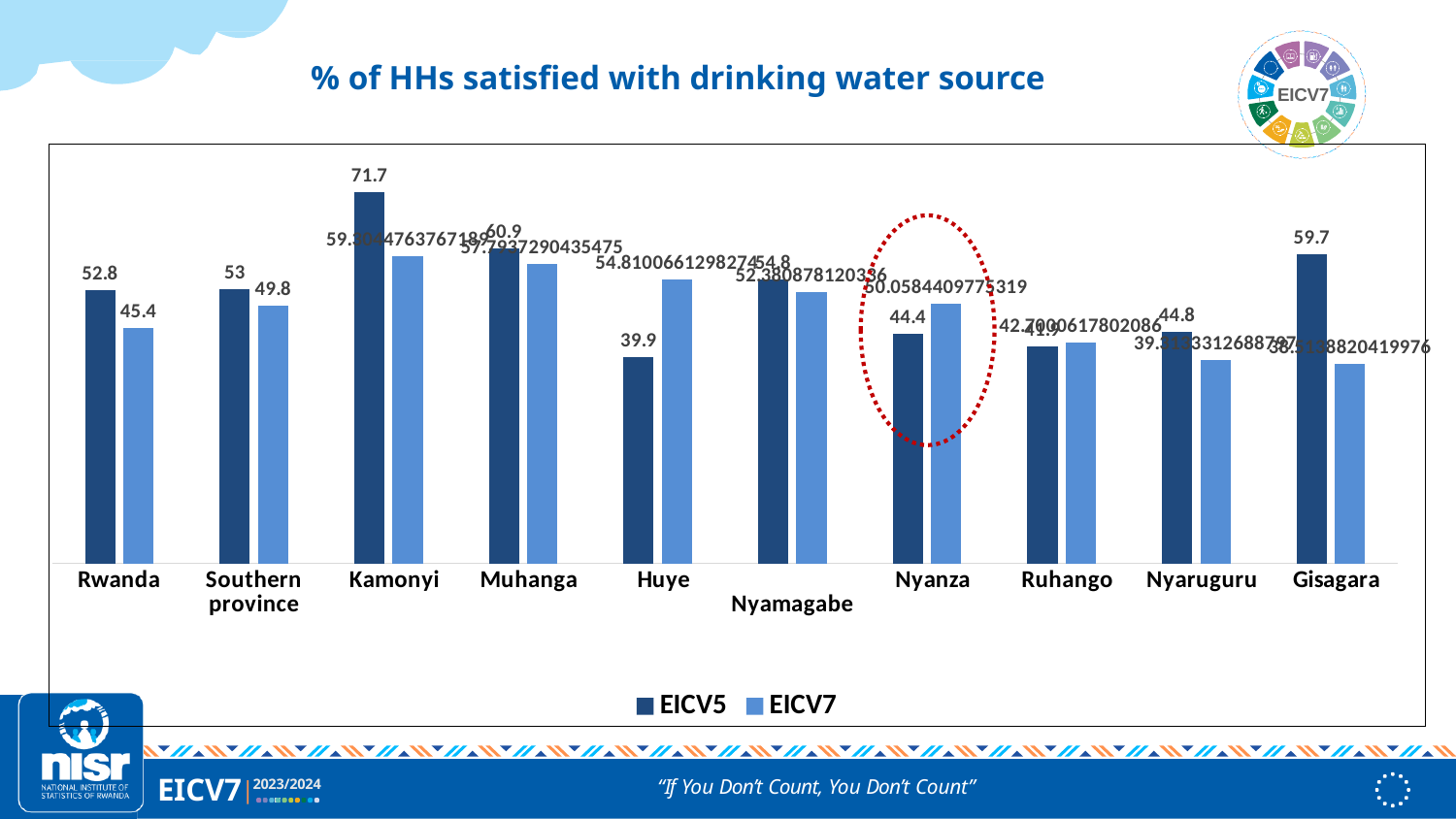
What is the EICV5 value for Kamonyi? 71.7 What is the EICV5 value for Gisagara? 59.7 What kind of chart is shown on the slide? bar chart What is the EICV5 value for Huye? 39.9 How many series does the legend list? 2 How many categories are shown on the x axis? 10 For Huye, which is larger, the EICV5 value or the EICV7 value? EICV7 Which category has the lowest EICV5 value? Huye What is the difference between the EICV5 and EICV7 values for Rwanda? 7.4 What is the EICV5 value for Rwanda? 52.8 Which category has the highest EICV5 value? Kamonyi What is the EICV7 value for Rwanda? 45.4